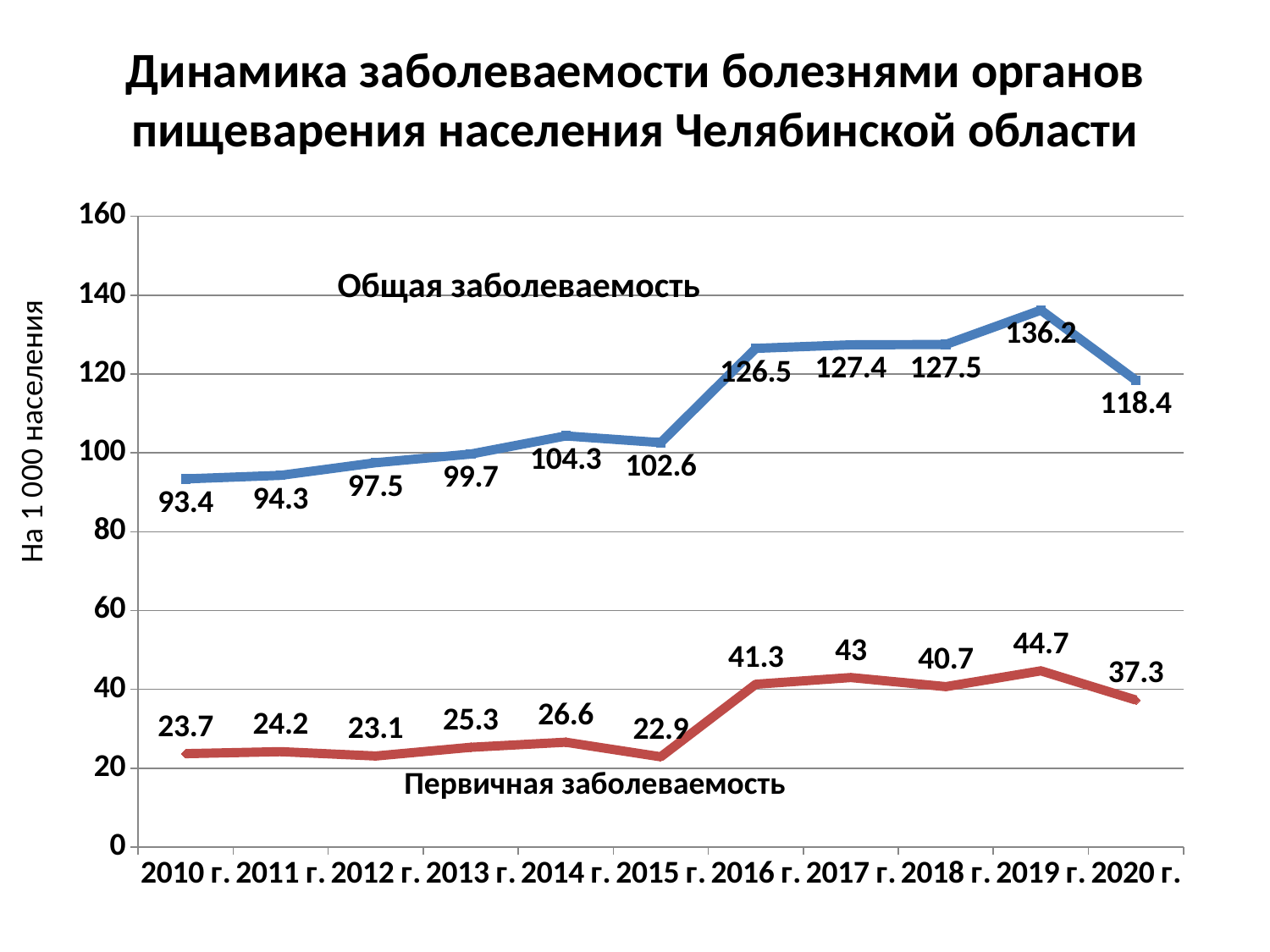
Which is larger: Первичная заболеваемость in 2017 г. or in 2018 г.? 2017 г. What is the difference between Общая заболеваемость in 2019 г. and 2020 г.? 17.8 What is the value of Общая заболеваемость in 2019 г.? 136.2 What is the value of Общая заболеваемость in 2010 г.? 93.4 In which year is Первичная заболеваемость lowest? 2015 г. What is the value of Первичная заболеваемость in 2015 г.? 22.9 In which year is Общая заболеваемость highest? 2019 г. How many years are shown on the x axis? 11 Does Общая заболеваемость rise or fall from 2010 г. to 2014 г.? rise How many series are plotted on the chart? 2 What is the label of the vertical axis? На 1 000 населения What type of chart is shown on the slide? line chart